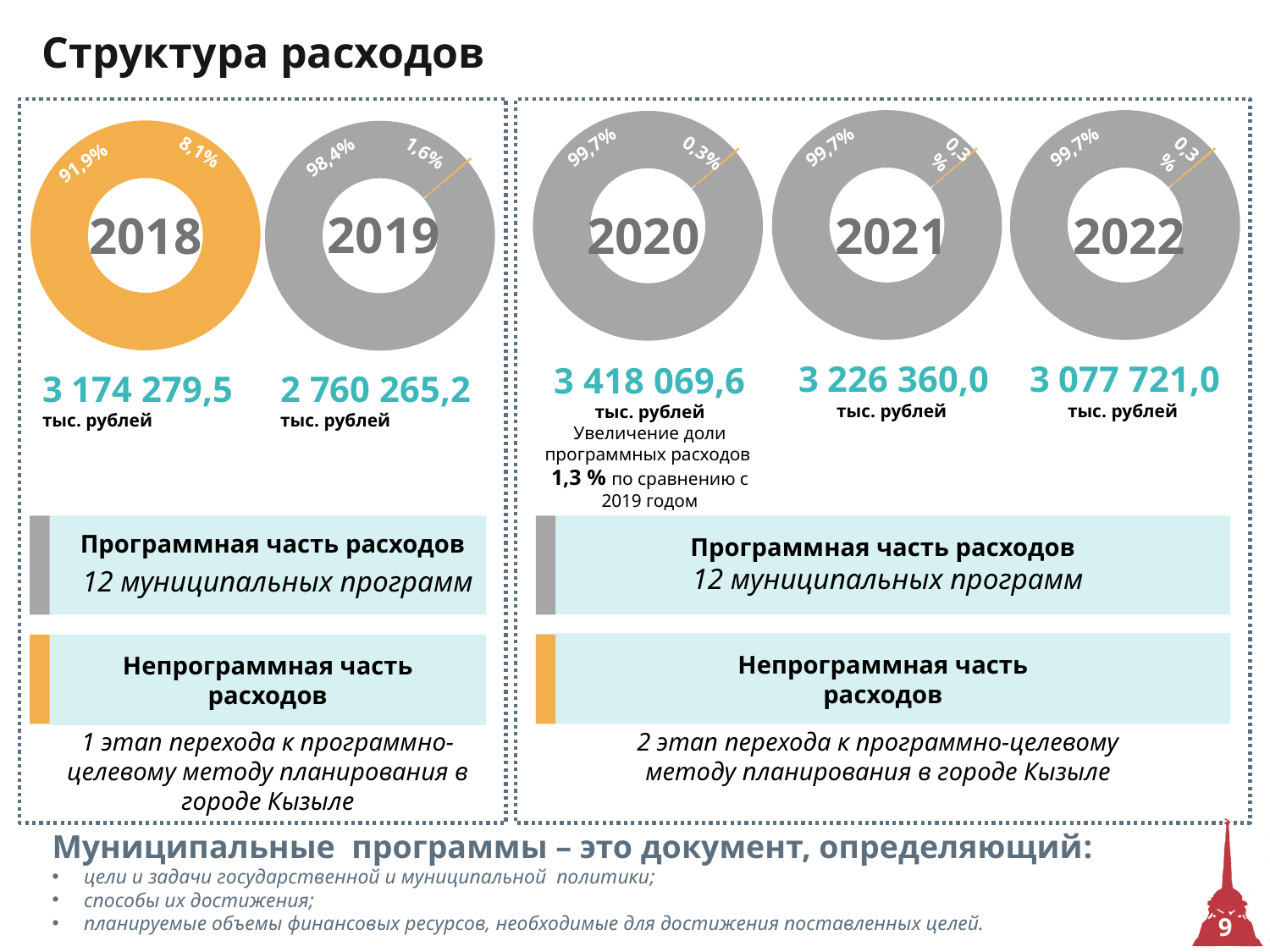
Does the share of the larger slice rise or fall from the 2018 chart to the 2020 chart? Rise What is the difference between the larger slice in the 2019 chart (98,4%) and the larger slice in the 2018 chart (91,9%)? 6,5% In the 2018 donut chart, what is the larger slice's share? 91,9% How many donut charts are shown on the slide? 5 In the 2020 donut chart, what share is shown for the smaller slice? 0,3% What type of chart is used to show the expenditure structure for each year? Donut (pie) chart In the 2018 donut chart, what is the smaller slice's share? 8,1% In the 2022 donut chart, what share is shown for the larger slice? 99,7% In the 2019 donut chart, what share is shown for the smaller slice? 1,6% In the 2019 donut chart, what share is shown for the larger slice? 98,4% What total amount (тыс. рублей) is shown under the 2020 donut chart? 3 418 069,6 Which is larger: the smaller slice in the 2018 chart or the smaller slice in the 2019 chart? 2018 (8,1%)